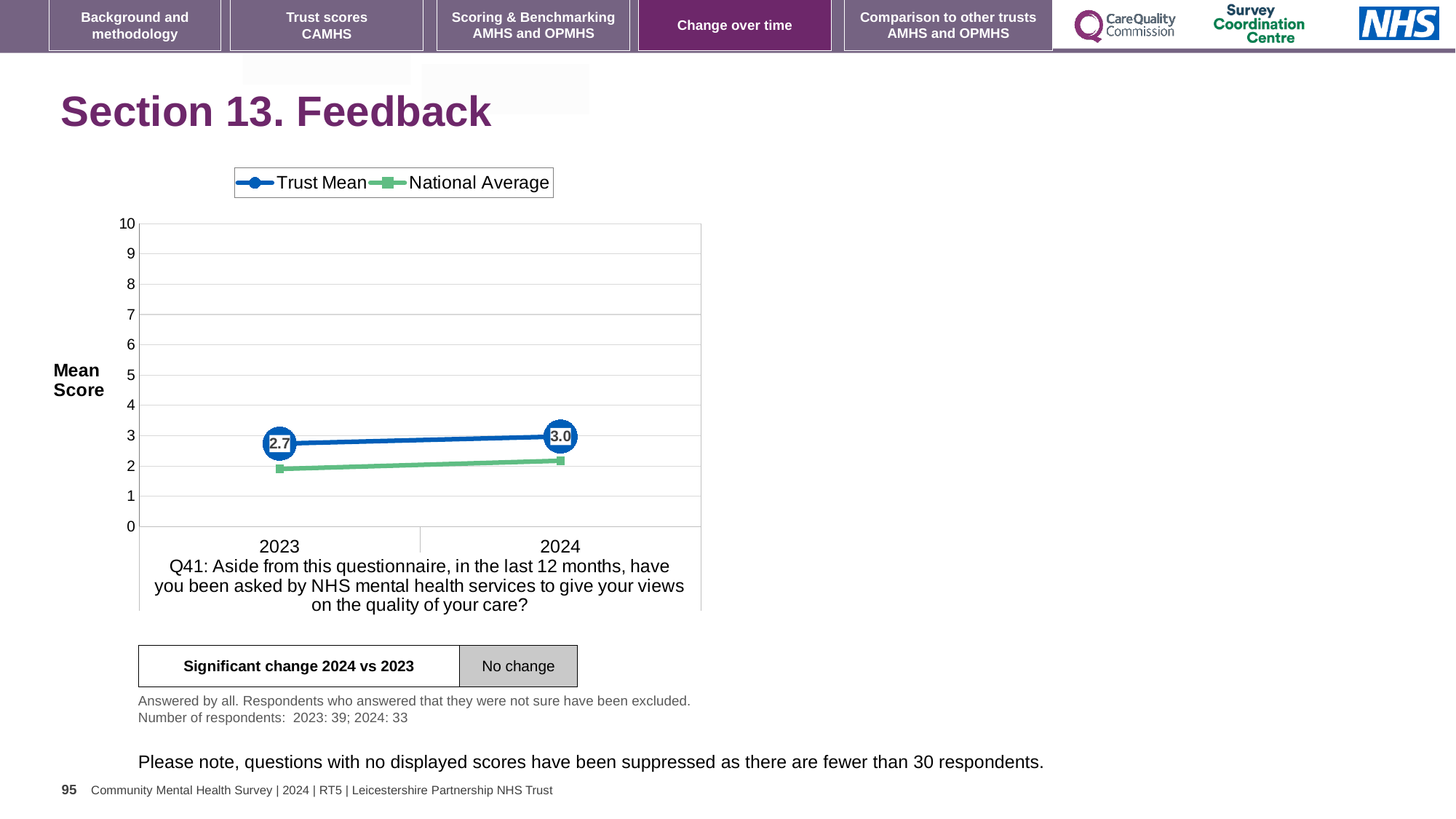
What is the difference between the Trust Mean in 2024 and in 2023? 0.3 How many years are shown on the x axis of the chart? 2 What is the Trust Mean value for 2024? 3.0 What is the Trust Mean value for 2023? 2.7 In which year is the Trust Mean lowest? 2023 In 2024, which is larger: the Trust Mean or the National Average? Trust Mean Is the National Average value for 2023 greater or less than 3? less How many series does the chart legend list? 2 What kind of chart is shown on the slide? line chart In which year is the Trust Mean highest? 2024 Is the National Average value for 2024 greater or less than 3? less Does the Trust Mean rise or fall from 2023 to 2024? rise